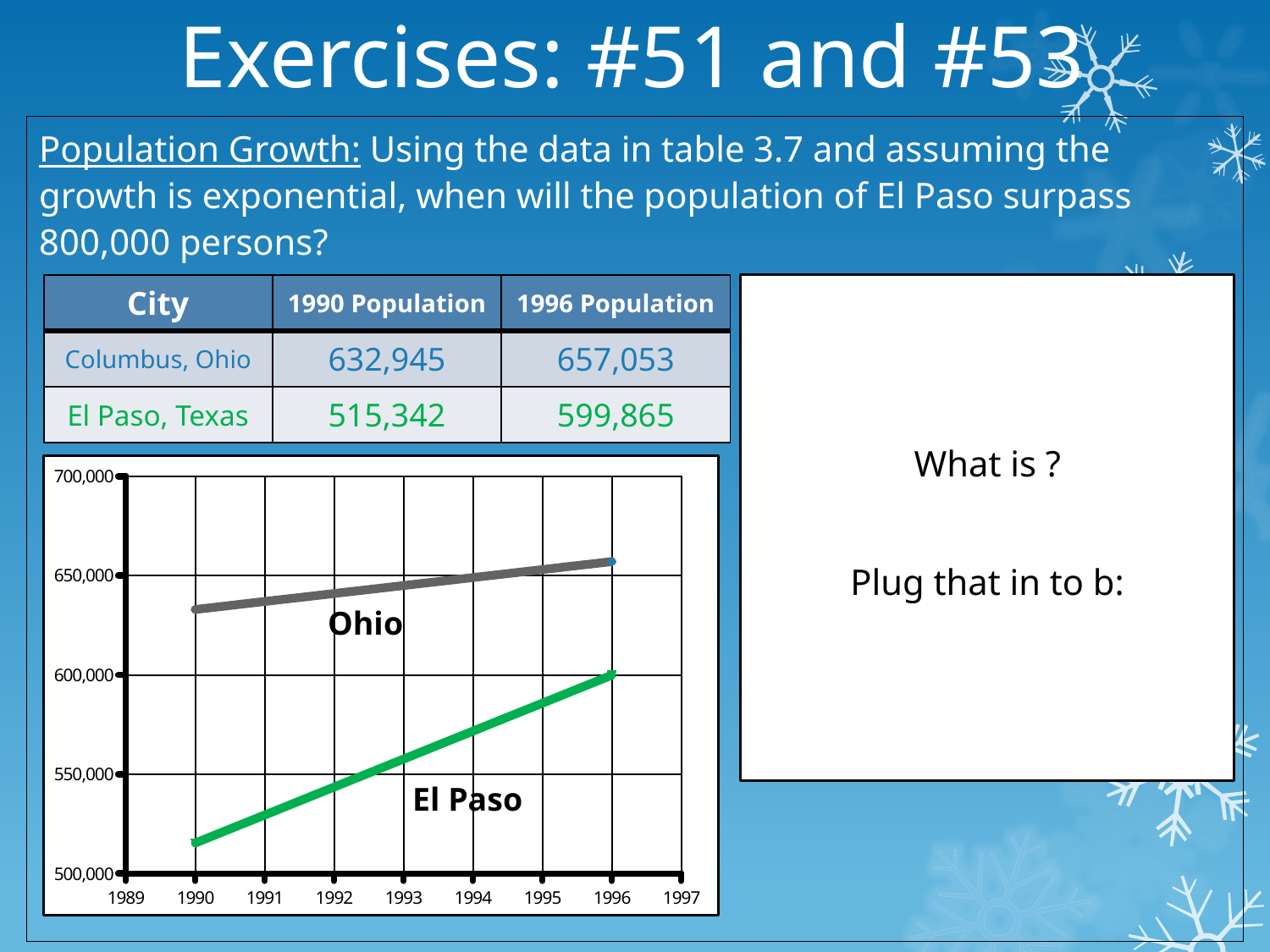
What colour is the El Paso line on the chart? green Is the El Paso value for 1996 greater or less than 650,000? less Does the Ohio line rise or fall from 1990 to 1996? rise Using the table values, by how much did the population of El Paso, Texas increase from 1990 to 1996? 84,523 Is the El Paso value for 1990 greater or less than 550,000? less Does the El Paso line rise or fall from 1990 to 1996? rise According to the table on the slide, what is the 1996 population of El Paso, Texas? 599,865 In 1996, which line is higher on the chart, Ohio or El Paso? Ohio How many series (lines) are plotted on the chart? 2 Is the Ohio value for 1990 greater or less than 600,000? greater What kind of chart is shown on the slide? line chart